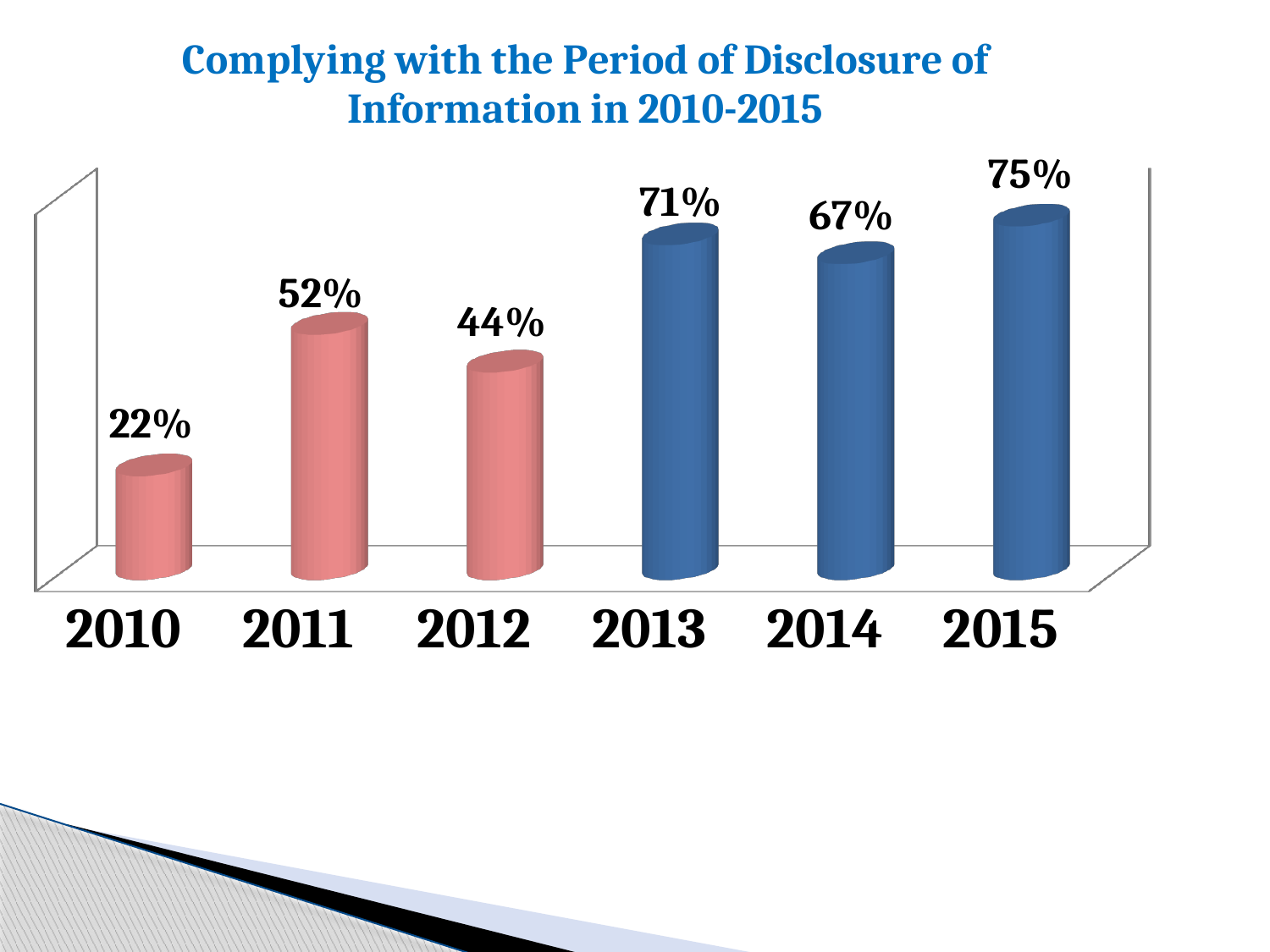
How many years are shown on the chart? 6 What is the value for 2010? 22% What is the difference between the values for 2011 and 2012? 8% Which is larger, the value for 2013 or the value for 2014? 2013 What kind of chart is this? Bar chart What is the value for 2014? 67% Do the values generally rise or fall from 2010 to 2015? Rise Which year has the lowest value? 2010 What is the difference between the values for 2015 and 2010? 53% What is the value for 2013? 71% What is the title of the chart? Complying with the Period of Disclosure of Information in 2010-2015 Which year has the highest value? 2015